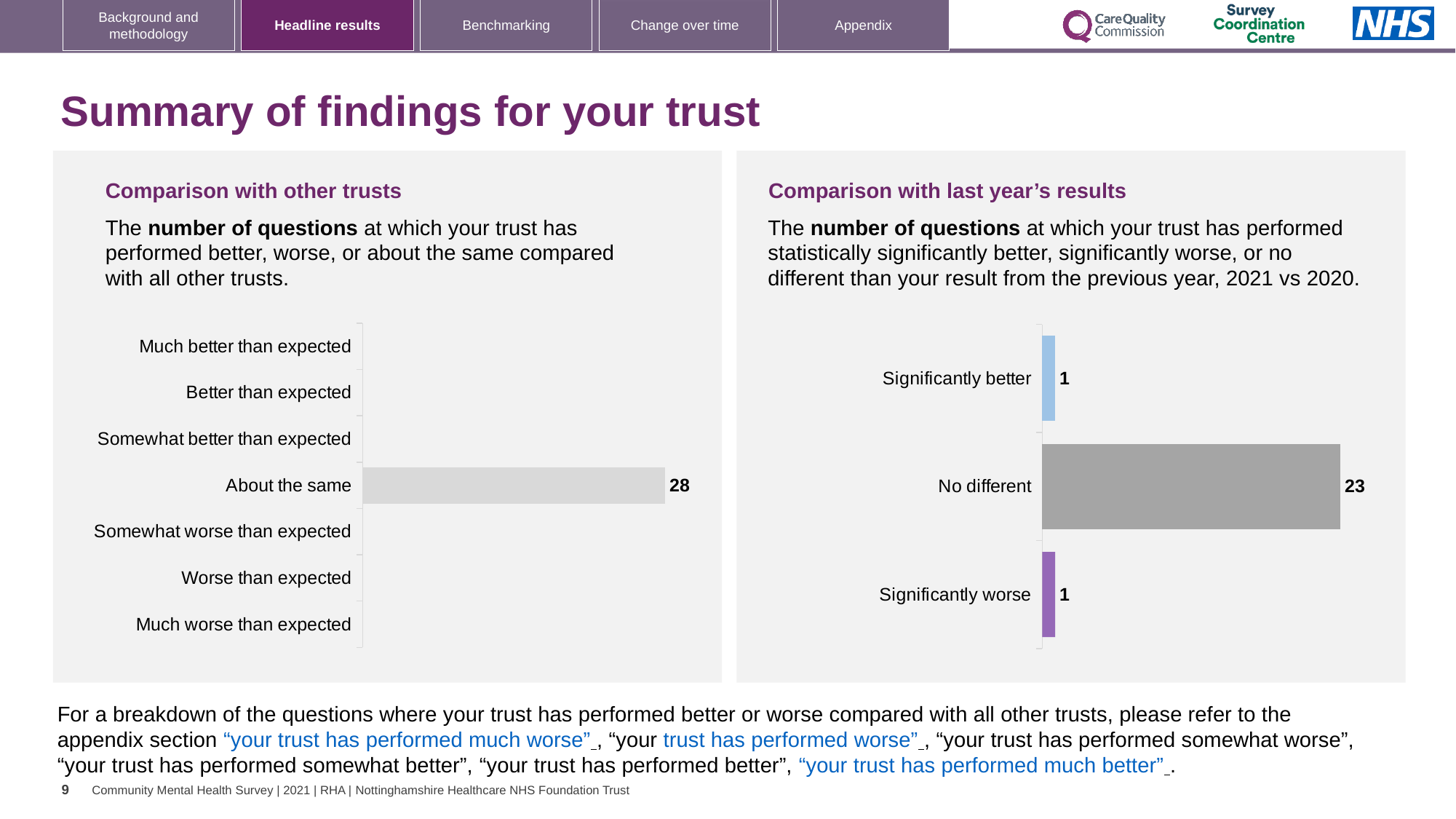
In the 'Comparison with last year's results' chart, which category has the highest value? No different In the 'Comparison with last year's results' chart, what is the value for 'Significantly worse'? 1 In the 'Comparison with last year's results' chart, what is the value for 'No different'? 23 What kind of chart is the 'Comparison with other trusts' chart? Bar chart In the 'Comparison with other trusts' chart, what is the value for 'About the same'? 28 In the 'Comparison with last year's results' chart, what colour is the 'Significantly worse' bar? Purple In the 'Comparison with other trusts' chart, how many categories are listed on the axis? 7 In the 'Comparison with last year's results' chart, what is the difference between 'No different' and 'Significantly better'? 22 In the 'Comparison with last year's results' chart, what is the value for 'Significantly better'? 1 In the 'Comparison with last year's results' chart, what is the total of all three values? 25 In the 'Comparison with last year's results' chart, how many categories are shown? 3 In the 'Comparison with other trusts' chart, which category has the highest value? About the same